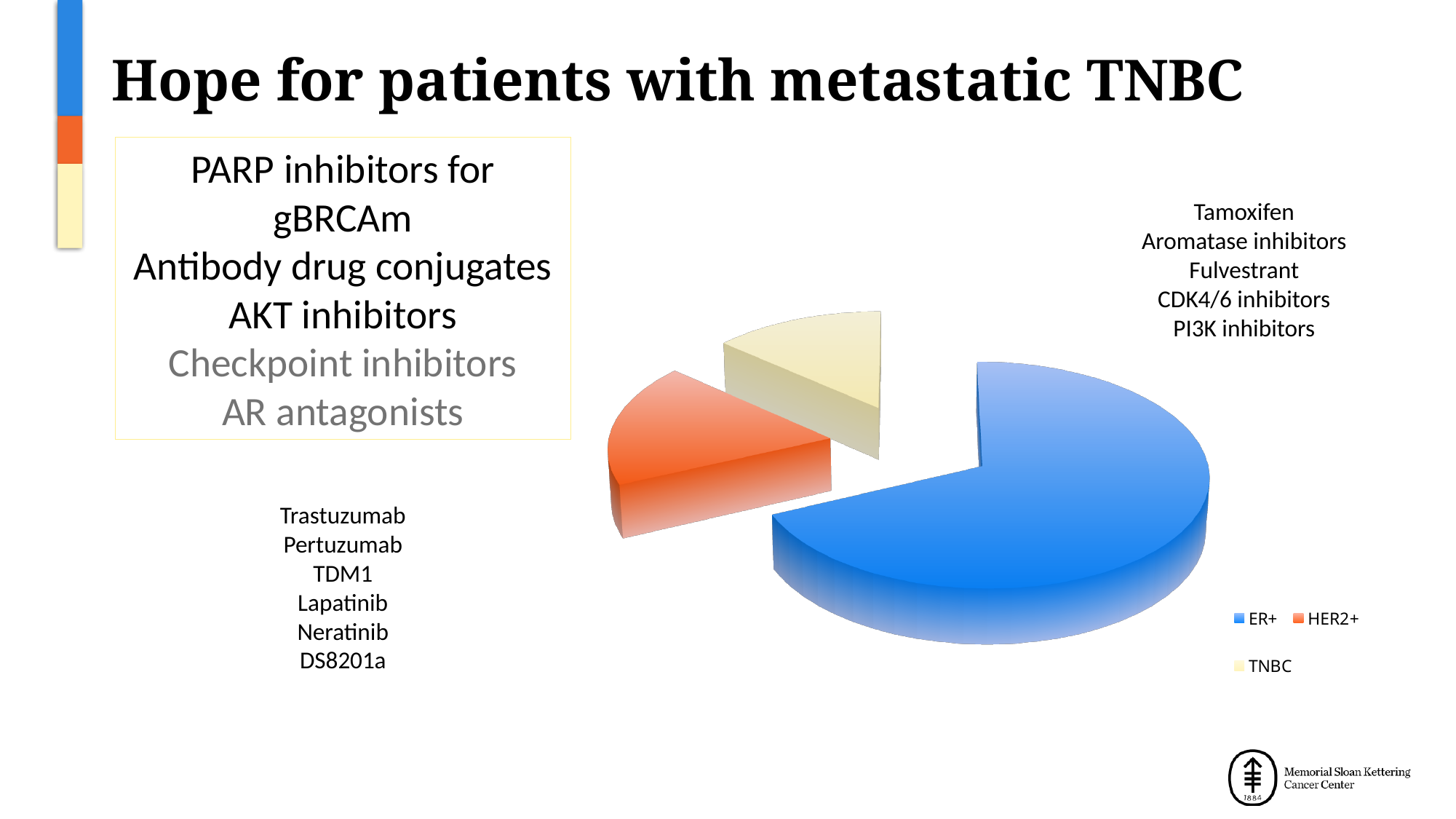
What colour is the TNBC slice in the pie chart? pale yellow What are the three categories listed in the pie chart's legend? ER+, HER2+, TNBC Does the ER+ slice take up more or less than half of the pie chart? more Which category has the largest slice in the pie chart? ER+ How many slices does the pie chart have? 3 What kind of chart is shown on the slide? pie chart Which slice is larger in the pie chart, ER+ or TNBC? ER+ How many entries does the pie chart's legend list? 3 What colour is the ER+ slice in the pie chart? blue Which slice is larger in the pie chart, ER+ or HER2+? ER+